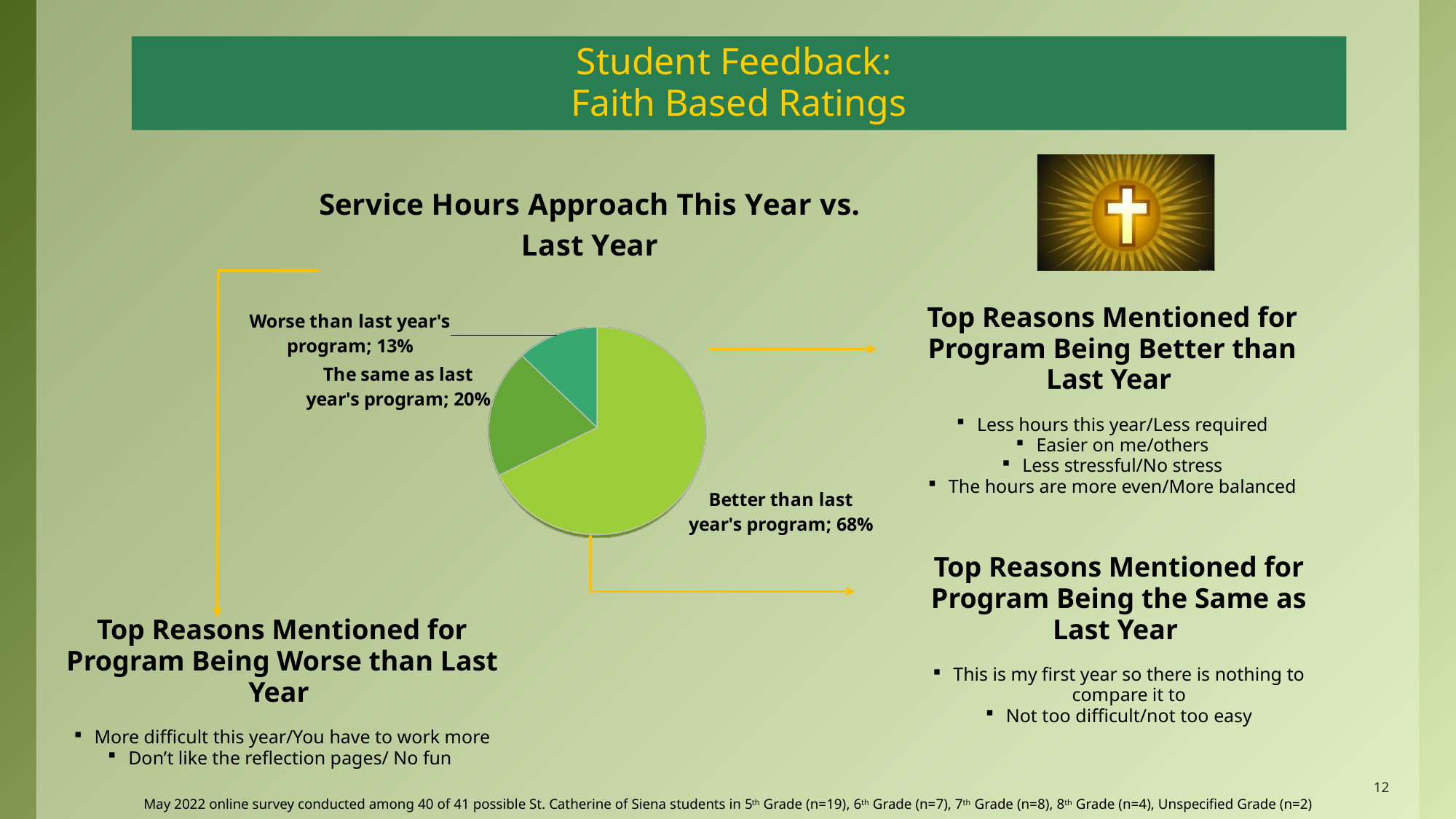
What percentage of students said the program was the same as last year's program? 20% What percentage of students said the program was worse than last year's program? 13% Which category has the largest share of the pie? Better than last year's program Which category has the smallest share of the pie? Worse than last year's program How many slices does the pie chart have? 3 What is the difference in percentage points between 'Better than last year's program' and 'The same as last year's program'? 48 What percentage of students said the program was better than last year's program? 68% What is the title of the chart? Service Hours Approach This Year vs. Last Year What is the difference in percentage points between 'The same as last year's program' and 'Worse than last year's program'? 7 What type of chart is shown on the slide? pie chart Which is larger: the share for 'The same as last year's program' or 'Worse than last year's program'? The same as last year's program